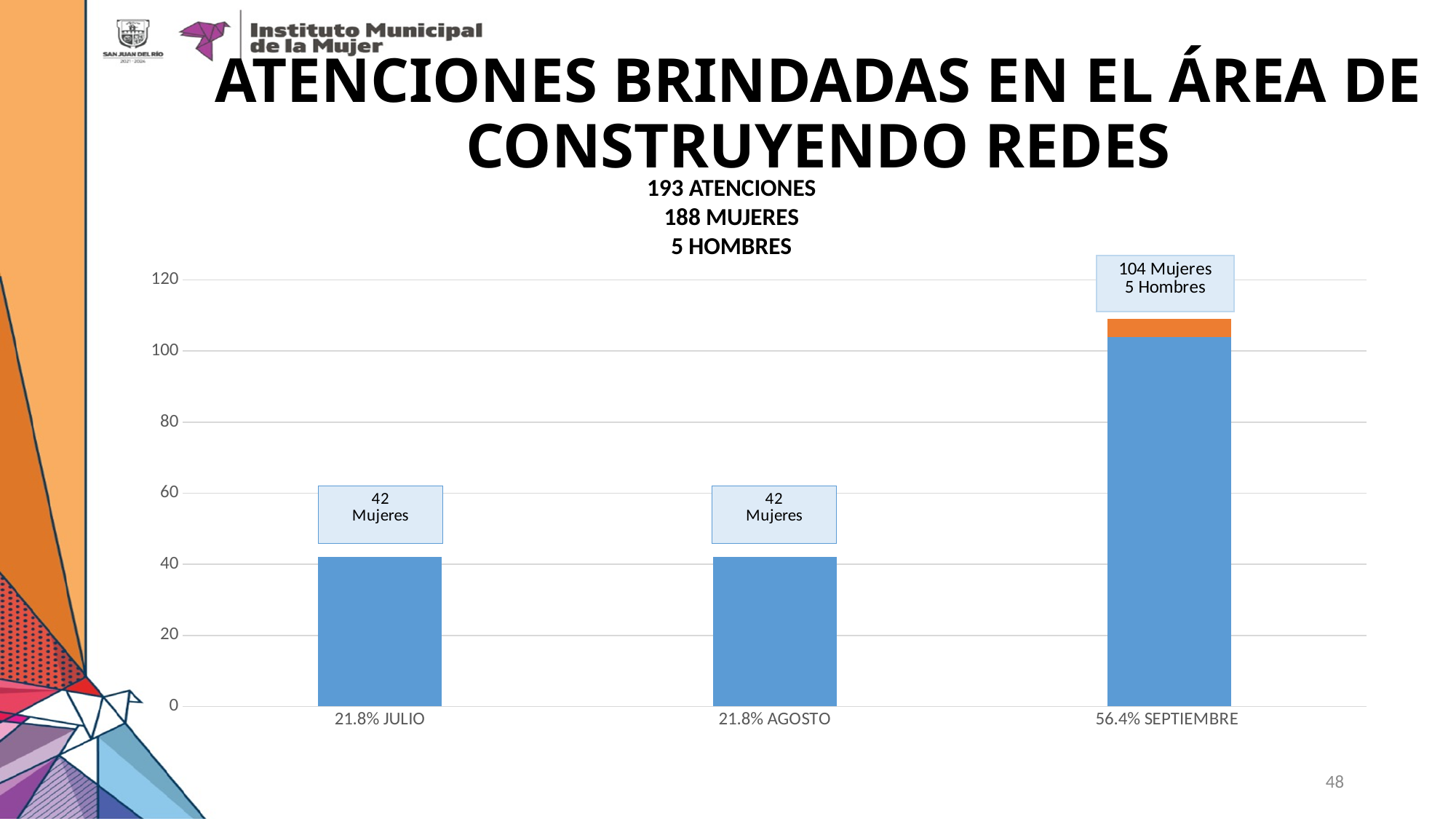
Is the bar for 56.4% SEPTIEMBRE greater or less than 100? greater How many categories (months) are shown on the x axis of the chart? 3 How many Mujeres are shown for 56.4% SEPTIEMBRE? 104 Which month has the tallest bar? 56.4% SEPTIEMBRE What is the difference between the number of Mujeres in 56.4% SEPTIEMBRE and in 21.8% JULIO? 62 What is the total height of the stacked bar for 56.4% SEPTIEMBRE (Mujeres plus Hombres)? 109 Is the bar for 21.8% AGOSTO greater or less than 60? less How many Mujeres are shown for 21.8% JULIO? 42 What kind of chart is shown on the slide? bar chart How many Mujeres are shown for 21.8% AGOSTO? 42 How many Hombres are shown for 56.4% SEPTIEMBRE? 5 What total number of atenciones is stated above the chart? 193 ATENCIONES